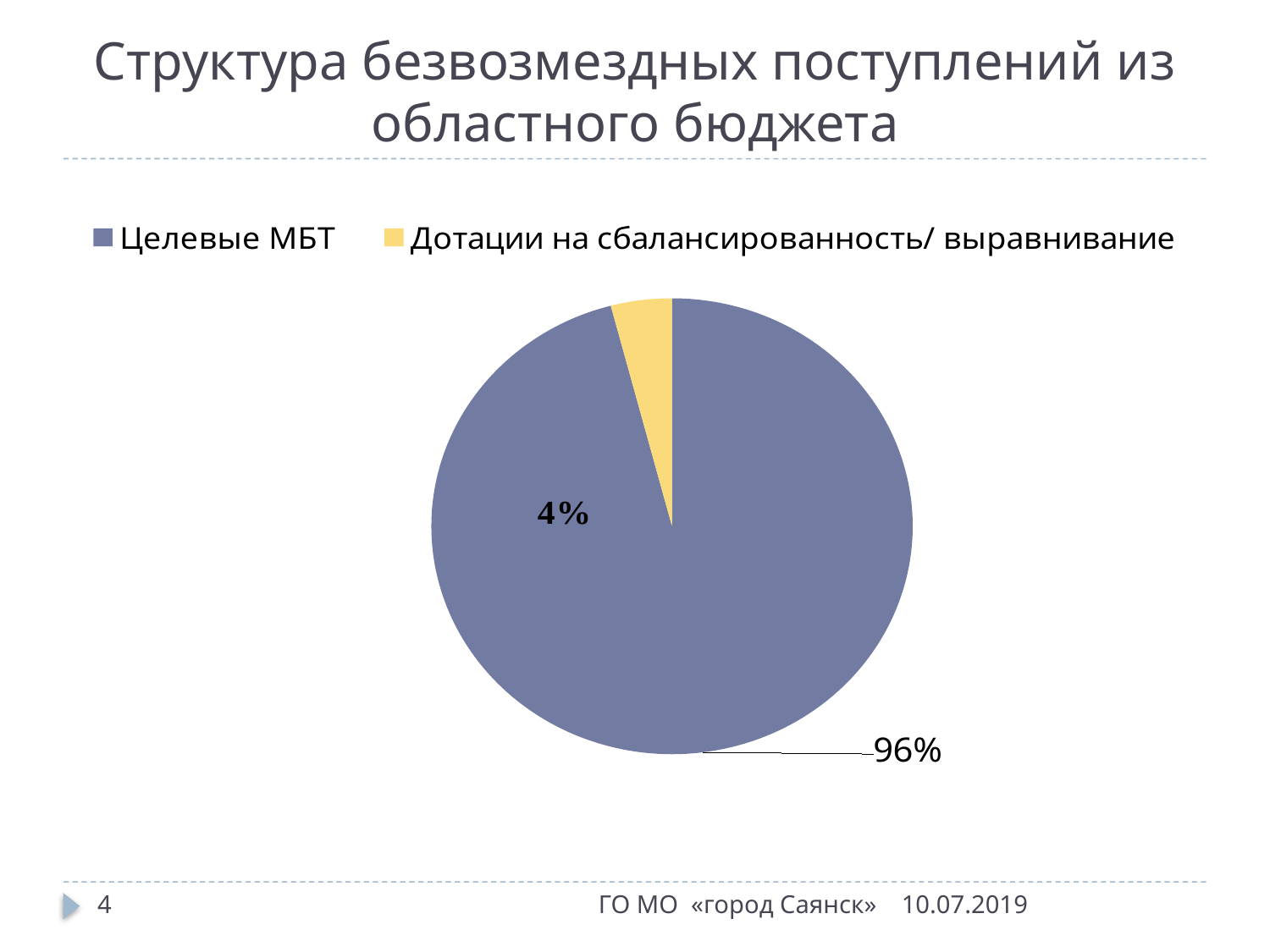
What share of the pie does Целевые МБТ represent? 96% Which category has the smallest slice of the pie? Дотации на сбалансированность/ выравнивание What colour is the slice for Дотации на сбалансированность/ выравнивание? yellow How many entries does the legend list? 2 Which is larger: the share for Целевые МБТ or the share for Дотации на сбалансированность/ выравнивание? Целевые МБТ What is the difference in percentage points between the Целевые МБТ slice and the Дотации на сбалансированность/ выравнивание slice? 92 How many slices does the pie chart have? 2 What is the title of the chart on the slide? Структура безвозмездных поступлений из областного бюджета What kind of chart is shown on the slide? pie chart What share of the pie does Дотации на сбалансированность/ выравнивание represent? 4% Which category has the largest slice of the pie? Целевые МБТ